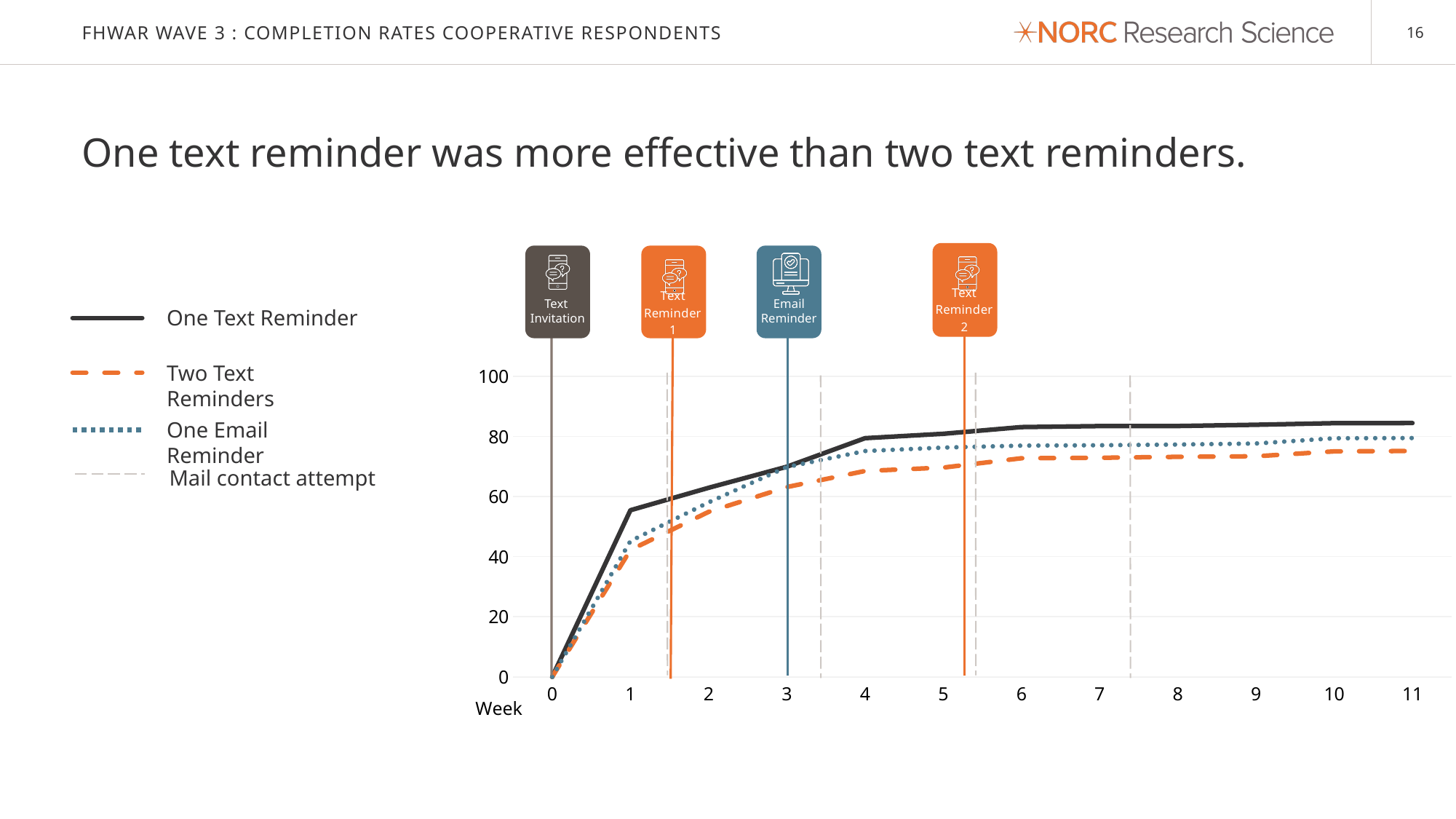
Which series has the highest value at week 11? One Text Reminder What is the value of the One Text Reminder series at week 0? 0 How many weeks are marked on the x axis of the chart? 12 Is the value for One Email Reminder at week 1 greater or less than 40? greater Do the completion rates rise or fall as the weeks increase? rise At week 11, which is larger: One Text Reminder or Two Text Reminders? One Text Reminder Is the value for Two Text Reminders at week 11 greater or less than 80? less Which series has the lowest value at week 11? Two Text Reminders Is the value for One Text Reminder at week 1 greater or less than 60? less How many line series does the chart legend list? 3 What kind of chart is shown on the slide? line chart